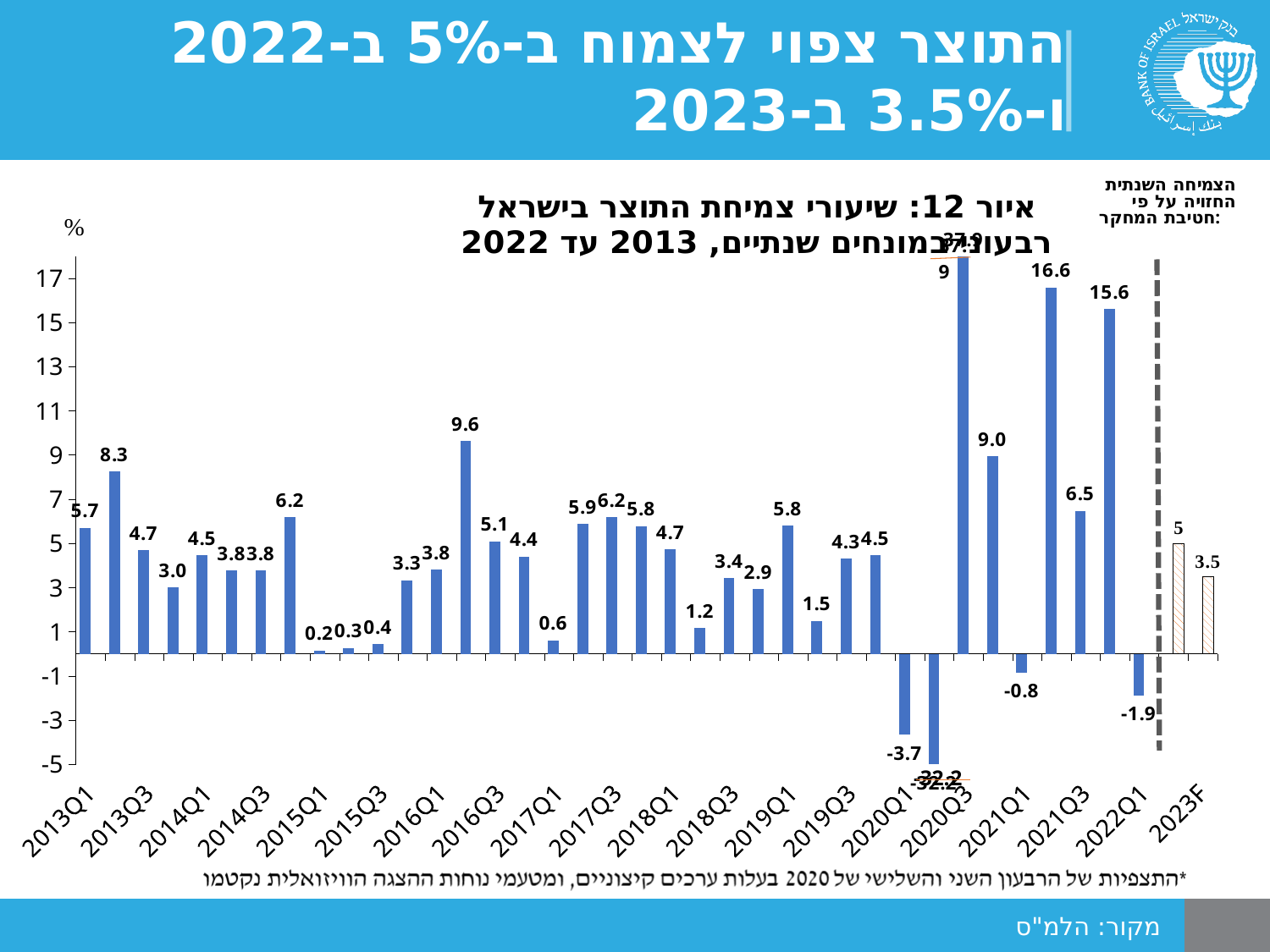
What is the value shown for 2020Q1? -3.7 Is the value for 2017Q1 greater or less than 1? less What is the growth rate shown for 2013Q1? 5.7 Which is larger, the value for 2019Q1 or the value for 2018Q1? 2019Q1 What is the forecast value shown for 2023F? 3.5 Do the values rise or fall from 2015Q1 to 2015Q3? rise What kind of chart is shown on the slide? bar chart What is the value shown for 2022Q1? -1.9 What is the value shown for 2021Q1? -0.8 What unit is shown at the top of the y axis? % What is the difference between the values for 2021Q1 and 2021Q3? 7.3 Which quarter has the highest growth rate in the chart? 2020Q3